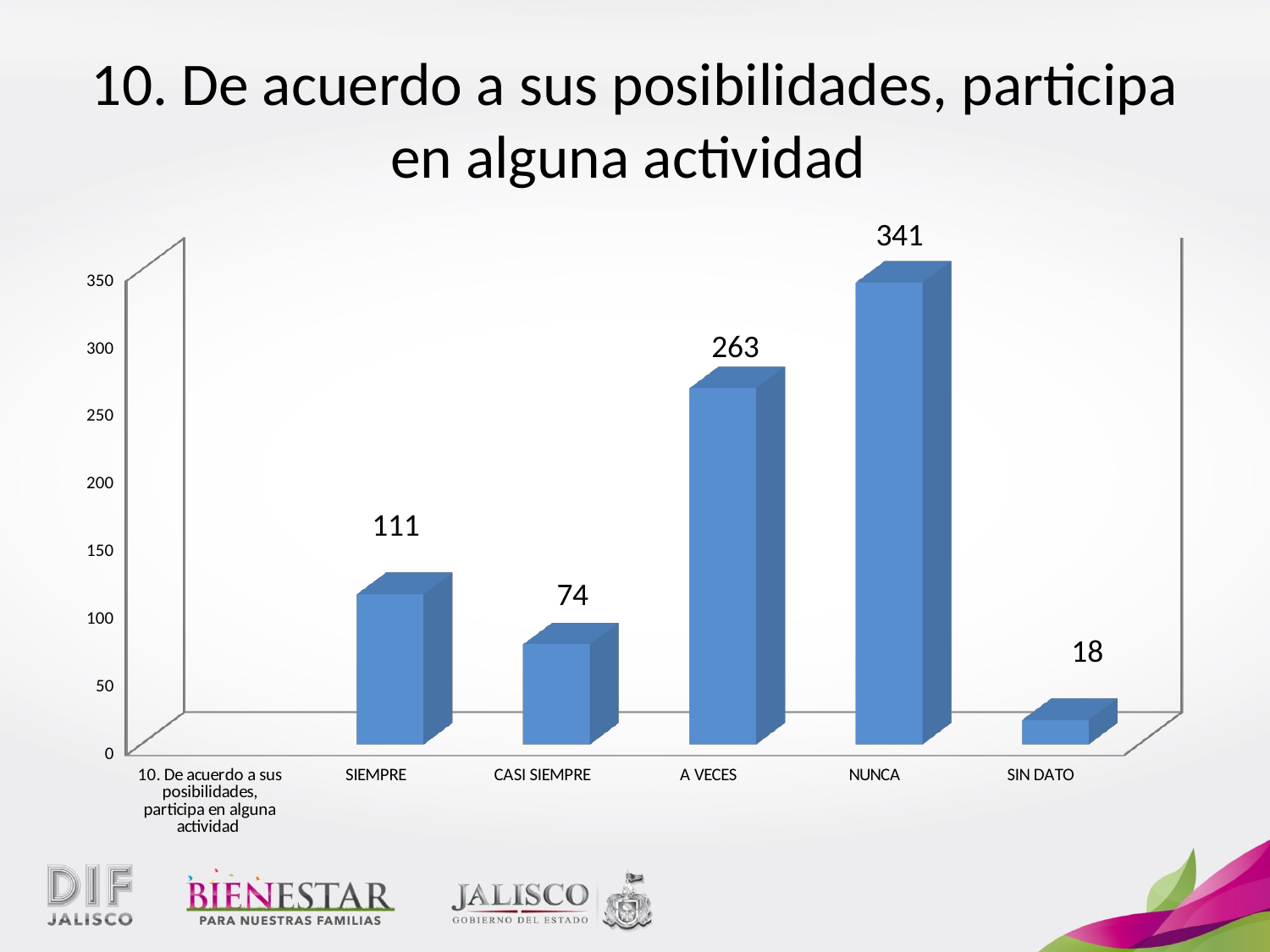
Which category has the lowest value? SIN DATO Which category has the highest value? NUNCA Is the value for A VECES greater or less than 250? greater What is the difference between the values for SIEMPRE and CASI SIEMPRE? 37 What kind of chart is shown on the slide? bar chart How many bars are plotted in the chart? 5 What is the value for SIN DATO? 18 What is the value for A VECES? 263 What is the value for NUNCA? 341 Which is larger, the value for SIEMPRE or the value for CASI SIEMPRE? SIEMPRE What is the difference between the values for NUNCA and A VECES? 78 What is the value for CASI SIEMPRE? 74